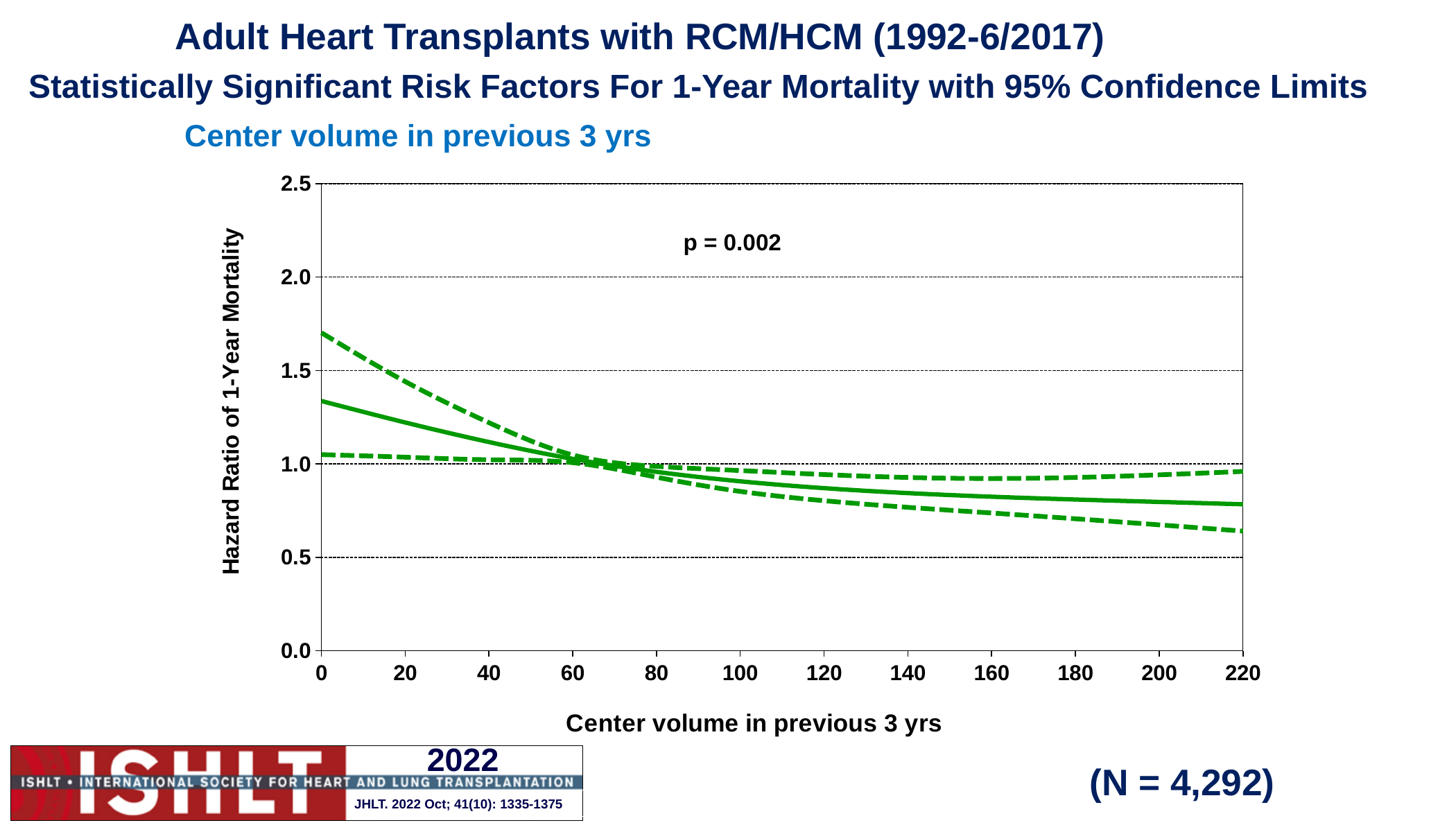
Is the hazard ratio on the solid line larger at a center volume of 0 or at a center volume of 220? 0 Is the lower dashed confidence limit at a center volume of 220 greater or less than 0.5? greater What is the label of the y-axis? Hazard Ratio of 1-Year Mortality Is the upper dashed confidence limit at a center volume of 0 greater or less than 1.5? greater Is the hazard ratio on the solid line at a center volume of 0 greater or less than 1.0? greater What p-value is printed on the chart? p = 0.002 Does the solid hazard ratio line rise or fall as center volume in previous 3 yrs increases from 0 to 220? fall What kind of chart is shown on the slide? line chart How many lines are plotted on the chart? 3